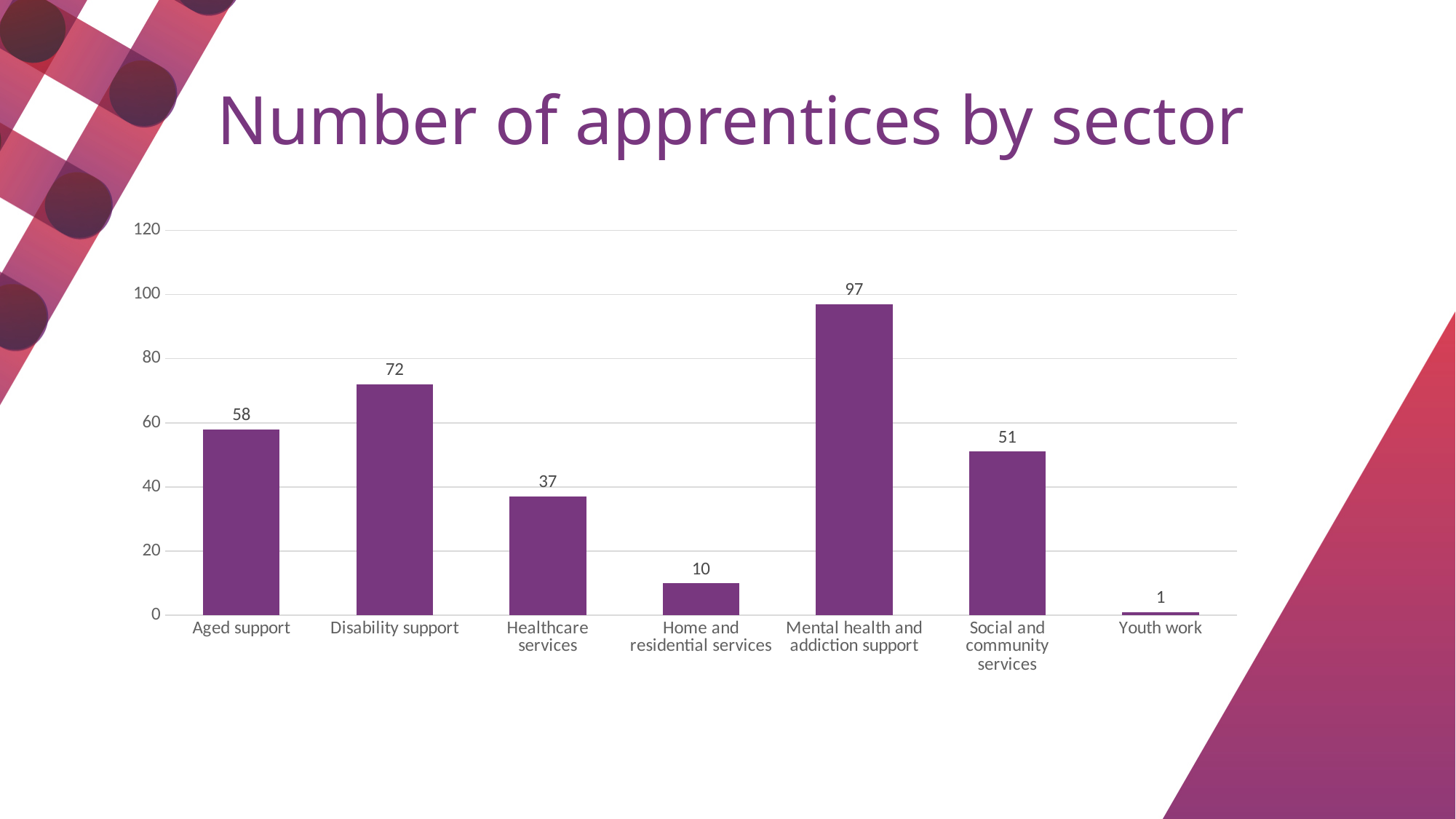
What is the title of the slide? Number of apprentices by sector Is the value for Disability support greater or less than 60? greater What kind of chart is shown on the slide? Bar chart Which sector has more apprentices, Aged support or Social and community services? Aged support What is the number of apprentices for Mental health and addiction support? 97 Which sector has the lowest number of apprentices? Youth work How many sectors are shown on the chart? 7 How many apprentices are in Home and residential services? 10 What is the difference in the number of apprentices between Disability support and Healthcare services? 35 What is the highest value shown on the vertical axis? 120 Which sector has the highest number of apprentices? Mental health and addiction support How many apprentices are in the Aged support sector? 58